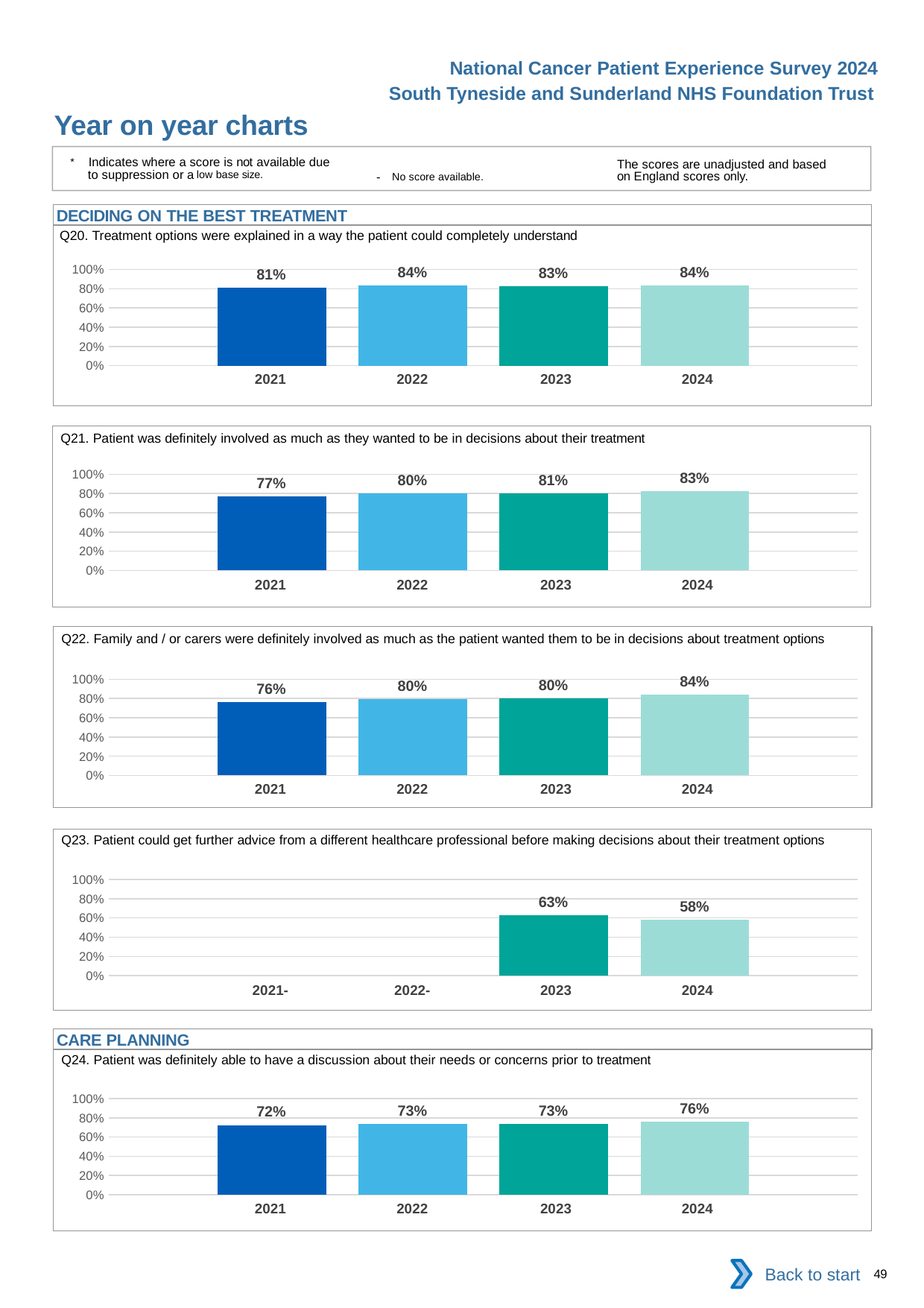
In the Q23 chart, which year has the larger score, 2023 or 2024? 2023 In the Q24 chart, do the scores rise or fall from 2021 to 2024? Rise In the Q24 chart (Patient was definitely able to have a discussion about their needs or concerns prior to treatment), which year has the lowest score? 2021 In the Q20 chart (Treatment options were explained in a way the patient could completely understand), what is the value for 2021? 81% In the Q20 chart, what kind of chart is used to show the scores? Bar chart In the Q21 chart (Patient was definitely involved as much as they wanted to be in decisions about their treatment), which year has the highest score? 2024 In the Q22 chart, what is the difference between the 2024 and 2021 scores? 8 percentage points In the Q21 chart, what is the difference between the 2024 and 2021 scores? 6 percentage points In the Q23 chart (Patient could get further advice from a different healthcare professional), how many years have a score shown? 2 In the Q23 chart, what is the value for 2024? 58% In the Q21 chart, what is the value for 2022? 80% In the Q22 chart (Family and / or carers were definitely involved as much as the patient wanted them to be), what is the value for 2024? 84%